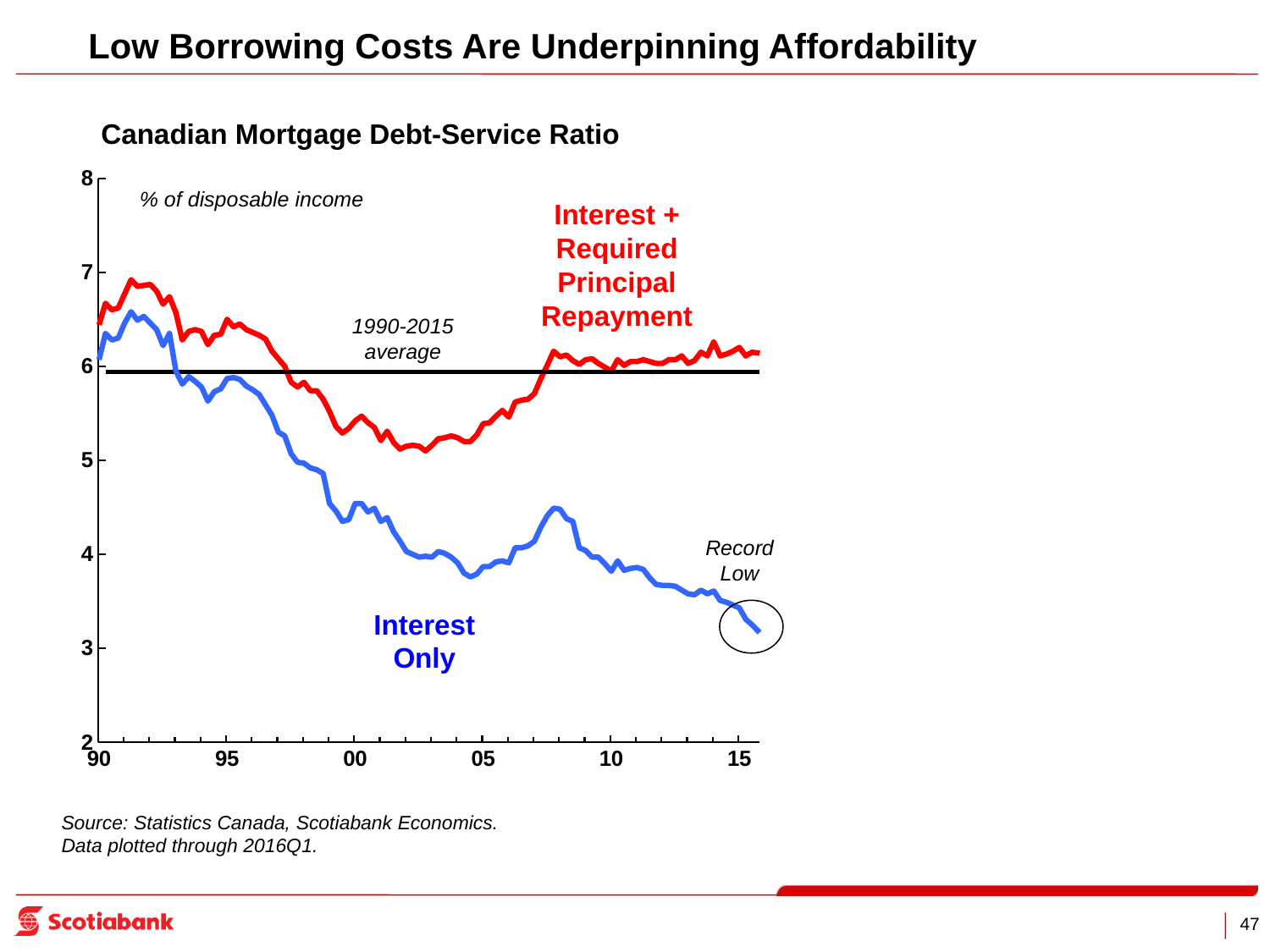
In what units are the values on the chart expressed? % of disposable income Is the value of the Interest + Required Principal Repayment series around 2015 greater or less than 5? greater Is the value of the Interest + Required Principal Repayment series around 2002 greater or less than 6? less Is the peak of the Interest Only series around 2008 greater or less than 5? less What is the title of the chart? Canadian Mortgage Debt-Service Ratio Which series is higher at the end of the chart (around 2015): Interest Only or Interest + Required Principal Repayment? Interest + Required Principal Repayment How many data series are plotted on the chart? 3 Does the Interest Only series rise or fall overall from 1990 to 2015? fall What kind of chart is shown on the slide? line chart Does the Interest + Required Principal Repayment series rise or fall between 2002 and 2008? rise